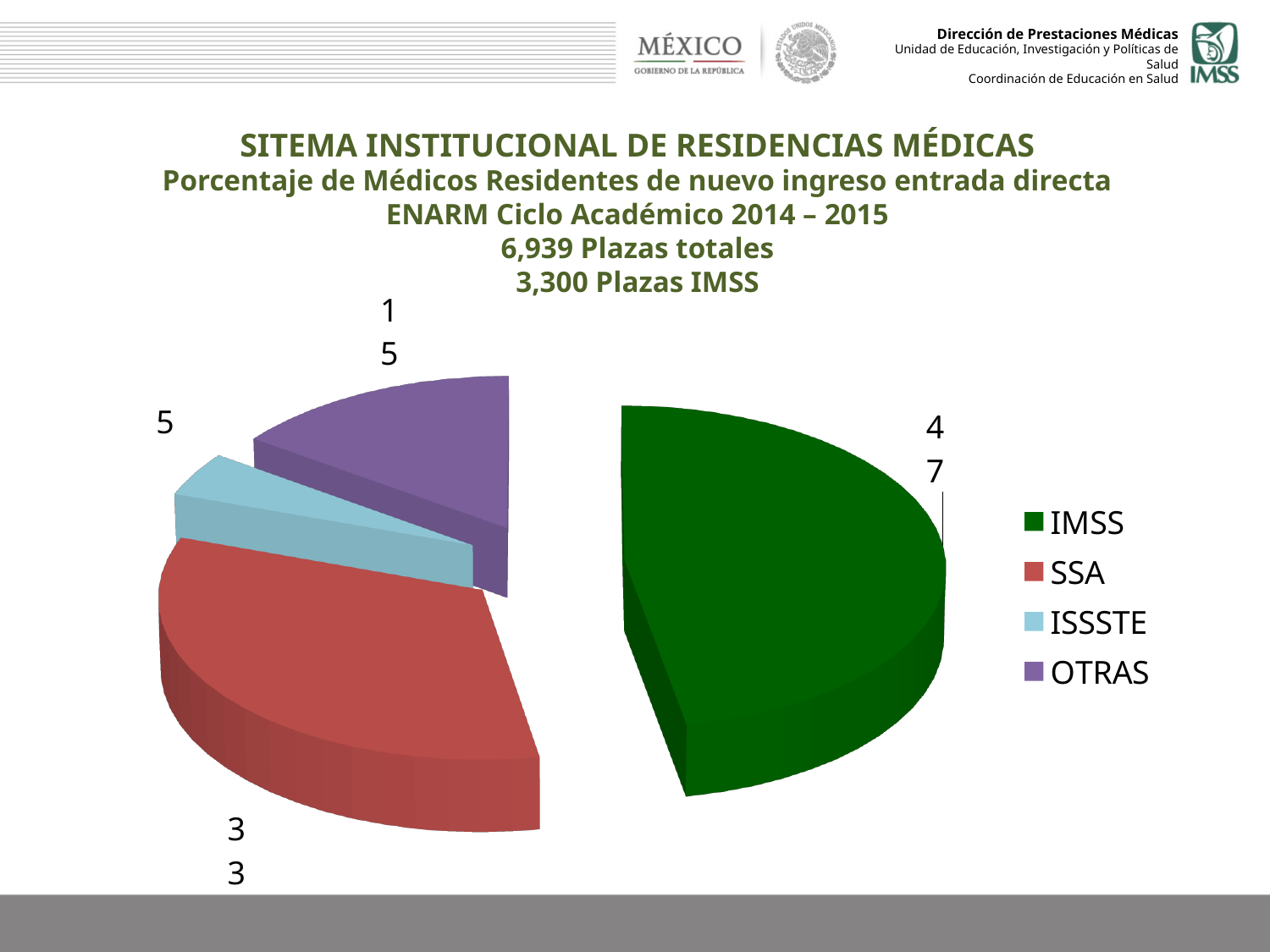
What value is labelled on the IMSS slice? 47 How many entries does the legend of the pie chart list? 4 Which slice is larger, ISSSTE or OTRAS? OTRAS How many slices does the pie chart have? 4 What value is labelled on the SSA slice? 33 What colour is the IMSS slice in the pie chart? green What value is labelled on the ISSSTE slice? 5 What kind of chart is shown on the slide? pie chart Which institution has the smallest slice in the pie chart? ISSSTE Which slice is larger, SSA or OTRAS? SSA Which institution has the largest slice in the pie chart? IMSS What value is labelled on the OTRAS slice? 15